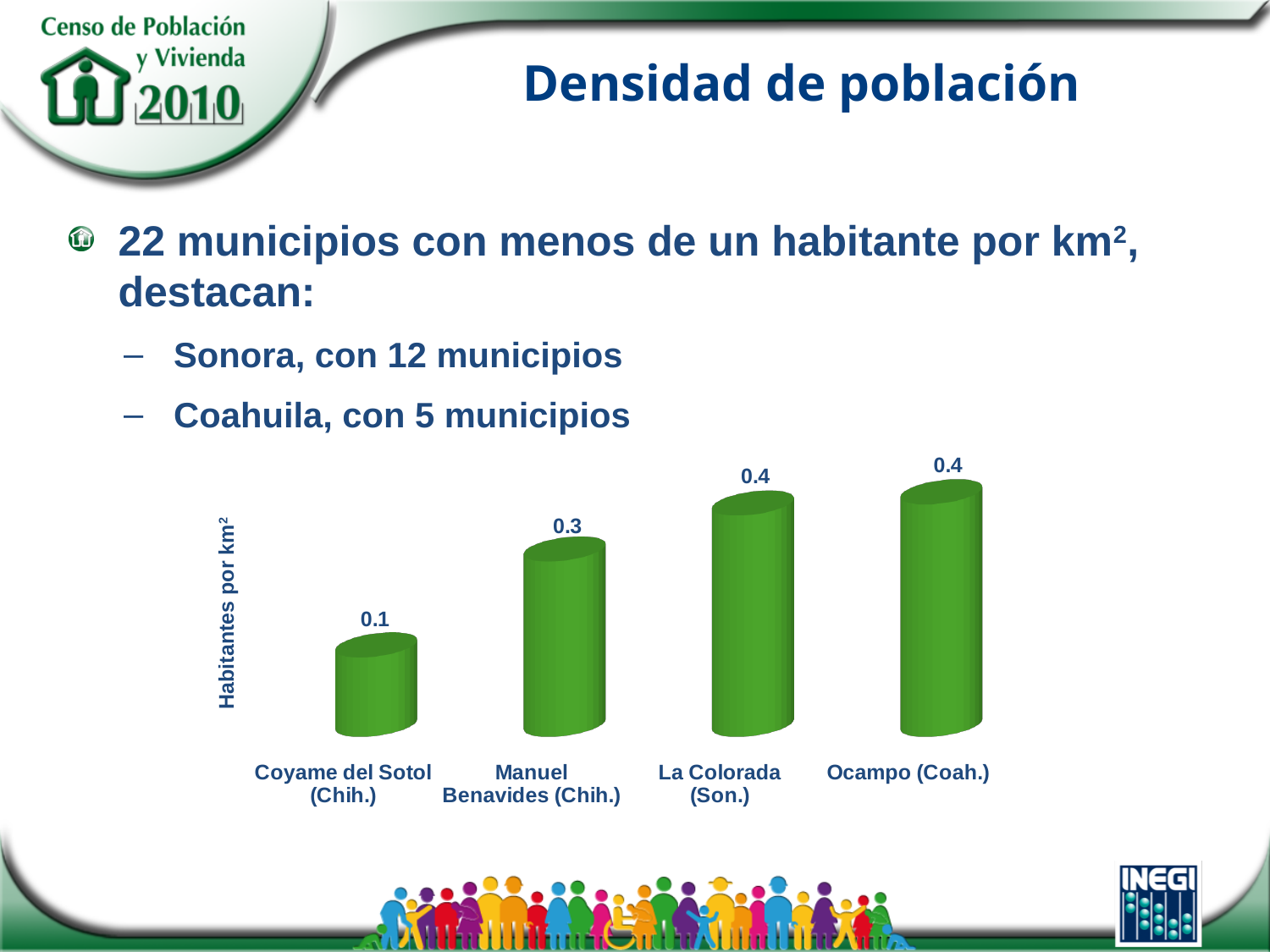
What value is shown for Ocampo (Coah.)? 0.4 What is the population density value shown for Coyame del Sotol (Chih.)? 0.1 What is the label on the vertical axis of the chart? Habitantes por km² What kind of chart is shown on the slide? Bar chart What is the difference between the values for La Colorada (Son.) and Coyame del Sotol (Chih.)? 0.3 What value is shown for La Colorada (Son.)? 0.4 What value is shown for Manuel Benavides (Chih.)? 0.3 What is the difference between the values for Manuel Benavides (Chih.) and Coyame del Sotol (Chih.)? 0.2 Which municipality has the lowest value in the chart? Coyame del Sotol (Chih.) Which is larger, the value for Manuel Benavides (Chih.) or the value for Coyame del Sotol (Chih.)? Manuel Benavides (Chih.) Do the values rise or fall from left to right across the chart? Rise How many municipalities are shown in the chart? 4